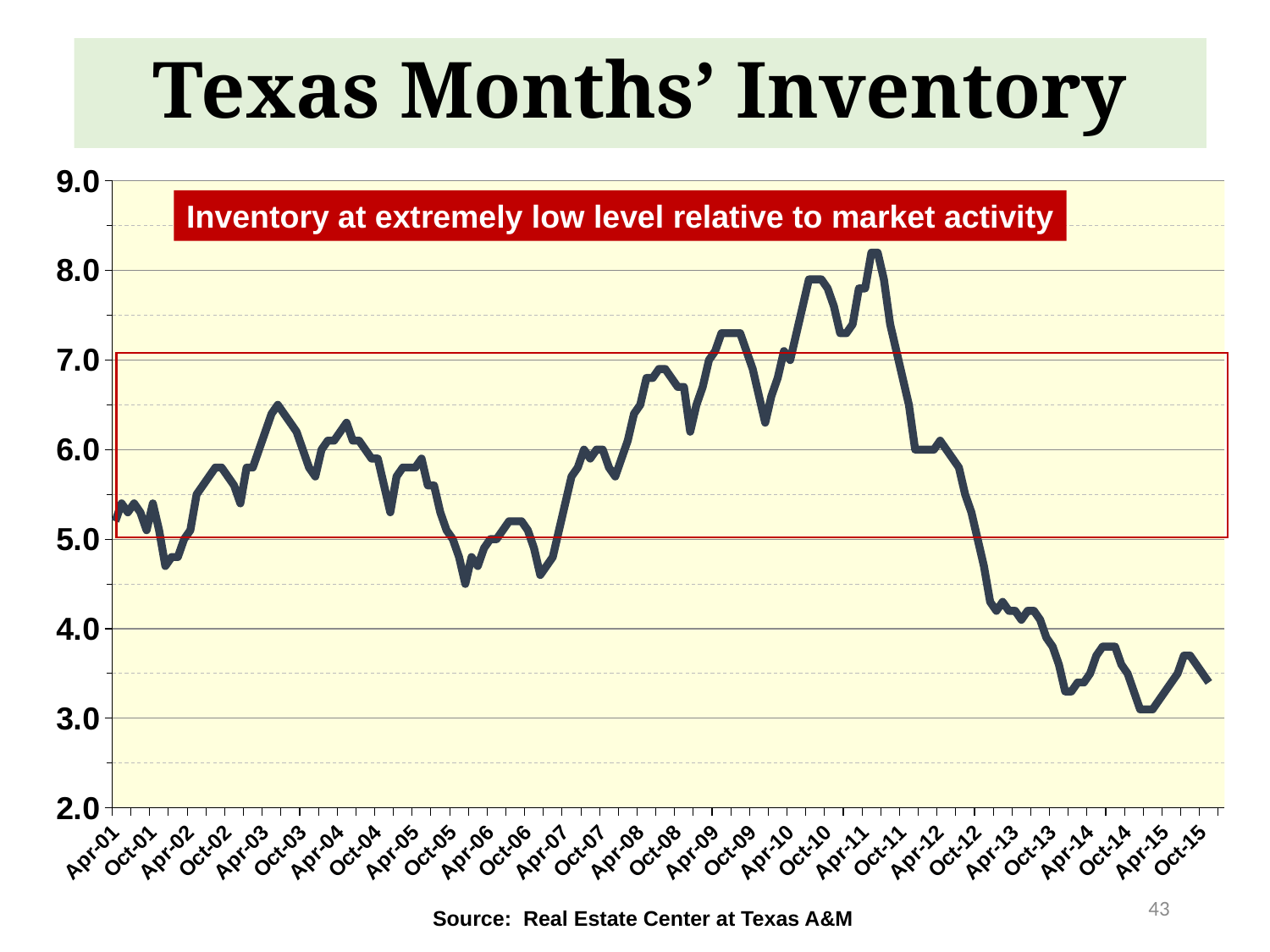
Is the value for Oct-10 greater or less than 7.0? greater Is the value for Apr-01 greater or less than 6.0? less What kind of chart is shown on the slide? line chart What does the red annotation box on the chart say? Inventory at extremely low level relative to market activity What is the title of the chart? Texas Months' Inventory Overall, does the line rise or fall from Apr-01 to Oct-15? fall Is the value for Apr-13 greater or less than 5.0? less Which is larger, the value for Apr-03 or the value for Apr-13? Apr-03 Which is larger, the value for Oct-10 or the value for Oct-15? Oct-10